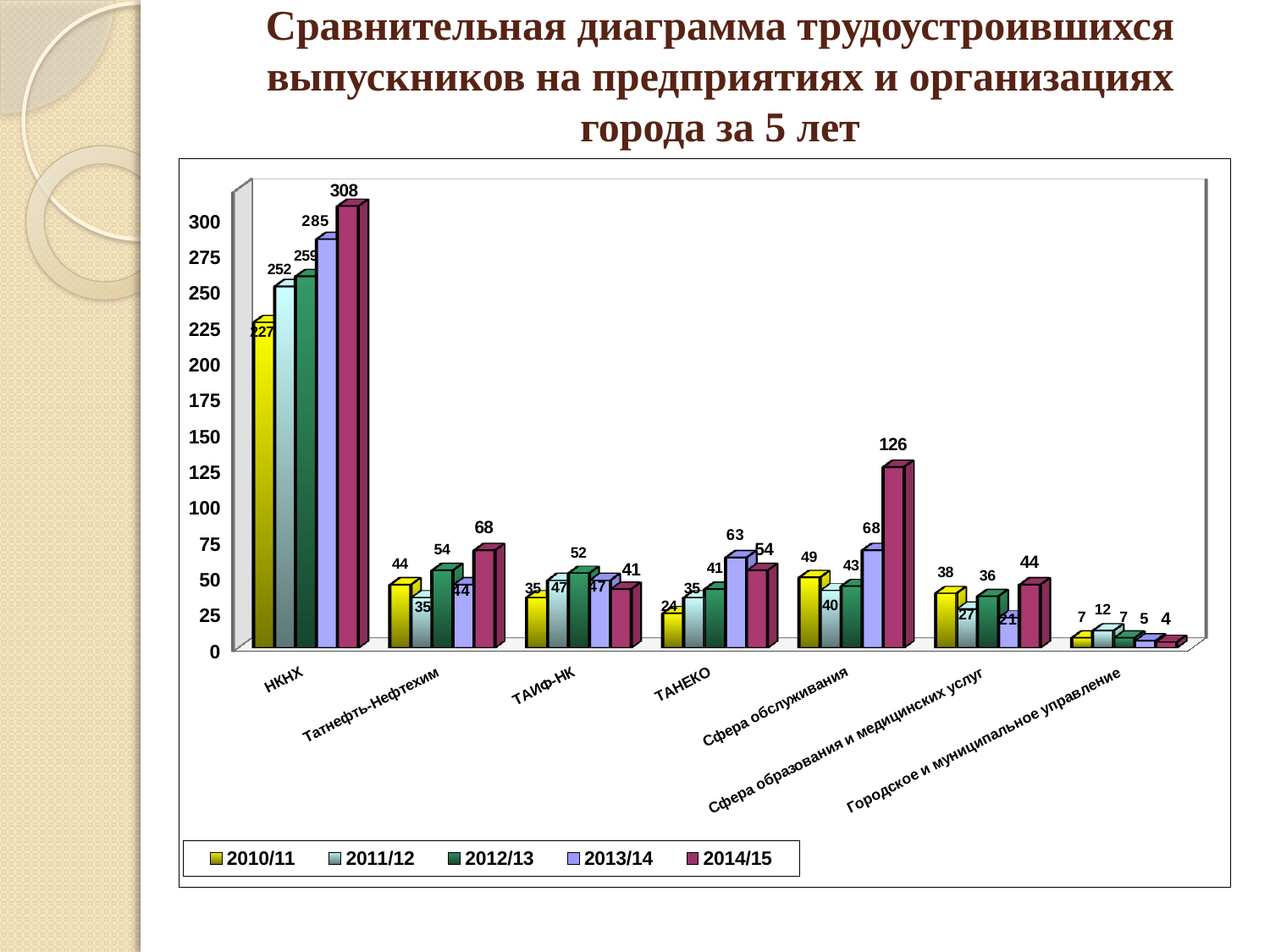
What is the difference between the 2014/15 and 2010/11 values for НКНХ? 81 How many series does the legend list? 5 What is the value for НКНХ in the 2014/15 series? 308 Which category has the highest value in the 2013/14 series? НКНХ Which is larger for ТАНЕКО: the 2013/14 value or the 2014/15 value? 2013/14 Is the value for НКНХ in 2011/12 greater or less than 250? greater Which category has the lowest value in the 2014/15 series? Городское и муниципальное управление What is the value for ТАНЕКО in the 2010/11 series? 24 What is the value for Сфера обслуживания in the 2014/15 series? 126 Do the values for НКНХ rise or fall from 2010/11 to 2014/15? Rise What kind of chart is shown on the slide? Bar chart How many categories are shown on the x axis? 7